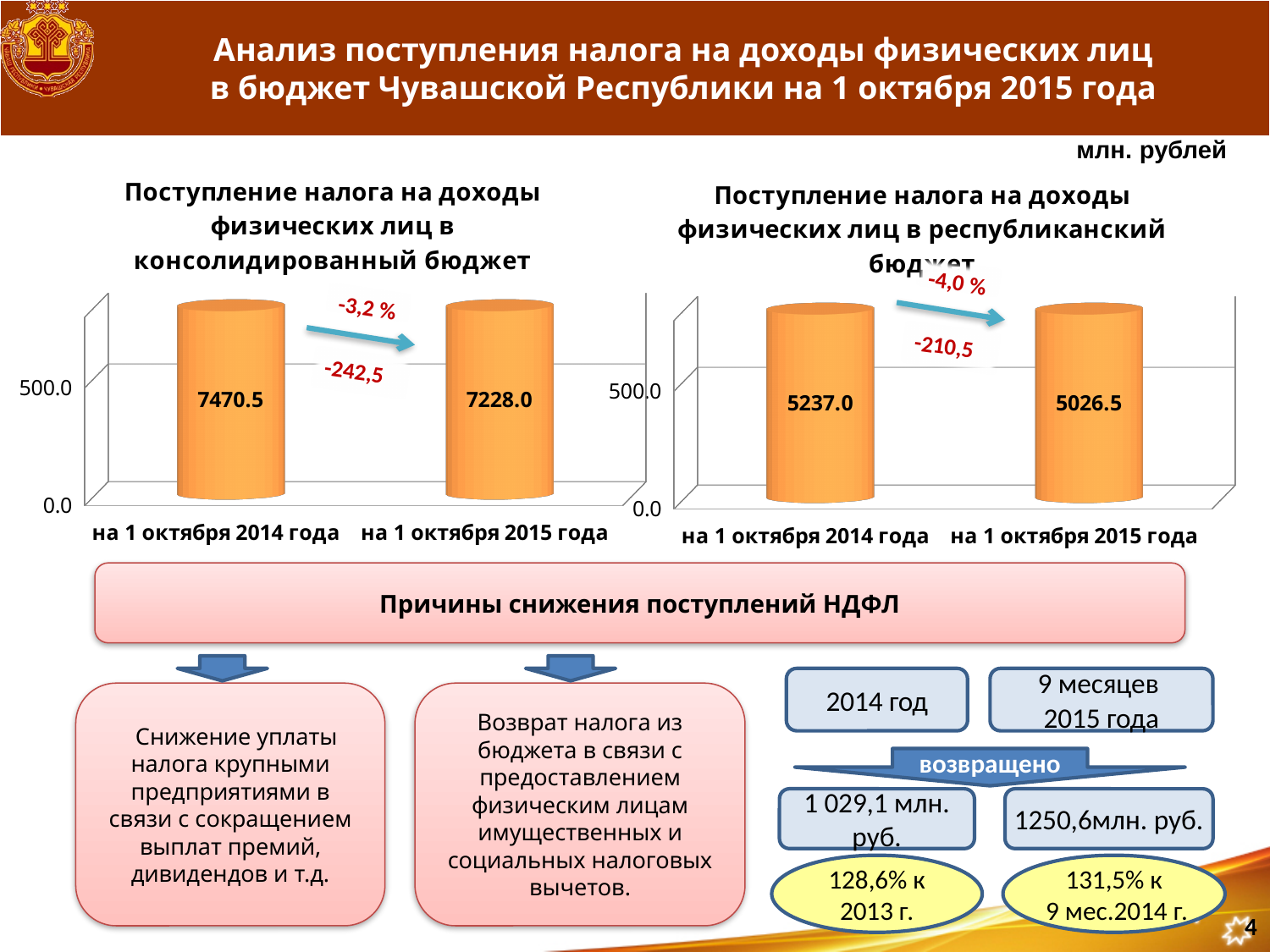
In the left chart (консолидированный бюджет), what is the value for 1 октября 2014 года? 7470.5 In the left chart (консолидированный бюджет), which date has the higher value? на 1 октября 2014 года In the left chart (консолидированный бюджет), what is the value for 1 октября 2015 года? 7228.0 In the left chart (консолидированный бюджет), what is the difference between the 2014 and 2015 values? 242.5 What type of chart is the right chart (республиканский бюджет)? bar chart In the right chart (республиканский бюджет), what is the value for 1 октября 2014 года? 5237.0 In the right chart (республиканский бюджет), what is the difference between the 2014 and 2015 values? 210.5 In the right chart (республиканский бюджет), do the values rise or fall from 2014 to 2015? fall What percentage change is annotated on the left chart (консолидированный бюджет)? -3,2 % How many bars are shown in the left chart (консолидированный бюджет)? 2 In the right chart (республиканский бюджет), which date has the lower value? на 1 октября 2015 года In the right chart (республиканский бюджет), what is the value for 1 октября 2015 года? 5026.5